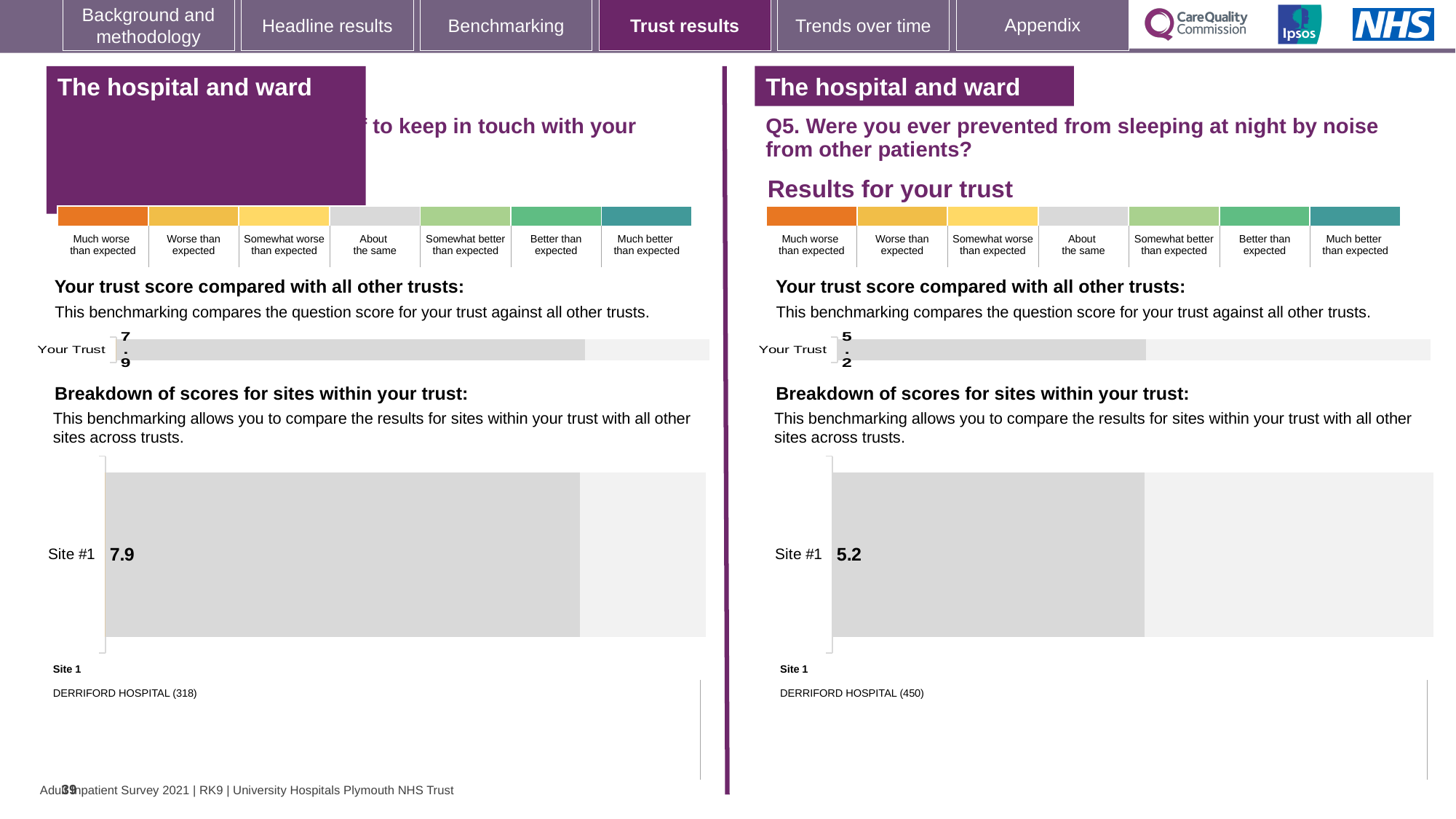
What type of chart is used to show the Site #1 score in the right-hand (Q5) breakdown section? Bar chart Which site is listed as Site 1 beneath the left-hand breakdown chart? DERRIFORD HOSPITAL (318) On the right-hand side of the slide (Q5), what is the 'Your Trust' score shown in the trust benchmarking chart? 5.2 Is the 'Your Trust' score in the right-hand (Q5) trust benchmarking chart greater or less than the 'Your Trust' score in the left-hand chart? less How many sites are shown in the right-hand 'Breakdown of scores for sites within your trust' chart (Q5)? 1 How many sites are shown in the left-hand 'Breakdown of scores for sites within your trust' chart? 1 What is the difference between the Site #1 score in the left-hand breakdown chart (7.9) and the Site #1 score in the right-hand Q5 breakdown chart (5.2)? 2.7 In the left-hand 'Breakdown of scores for sites within your trust' chart, what score is shown for Site #1? 7.9 On the left-hand side of the slide, what is the 'Your Trust' score shown in the trust benchmarking chart? 7.9 Which is larger: the Site #1 score in the left-hand breakdown chart or the Site #1 score in the right-hand (Q5) breakdown chart? Left-hand chart (7.9) In the right-hand 'Breakdown of scores for sites within your trust' chart (Q5), what score is shown for Site #1? 5.2 Which site is listed as Site 1 beneath the right-hand (Q5) breakdown chart? DERRIFORD HOSPITAL (450)